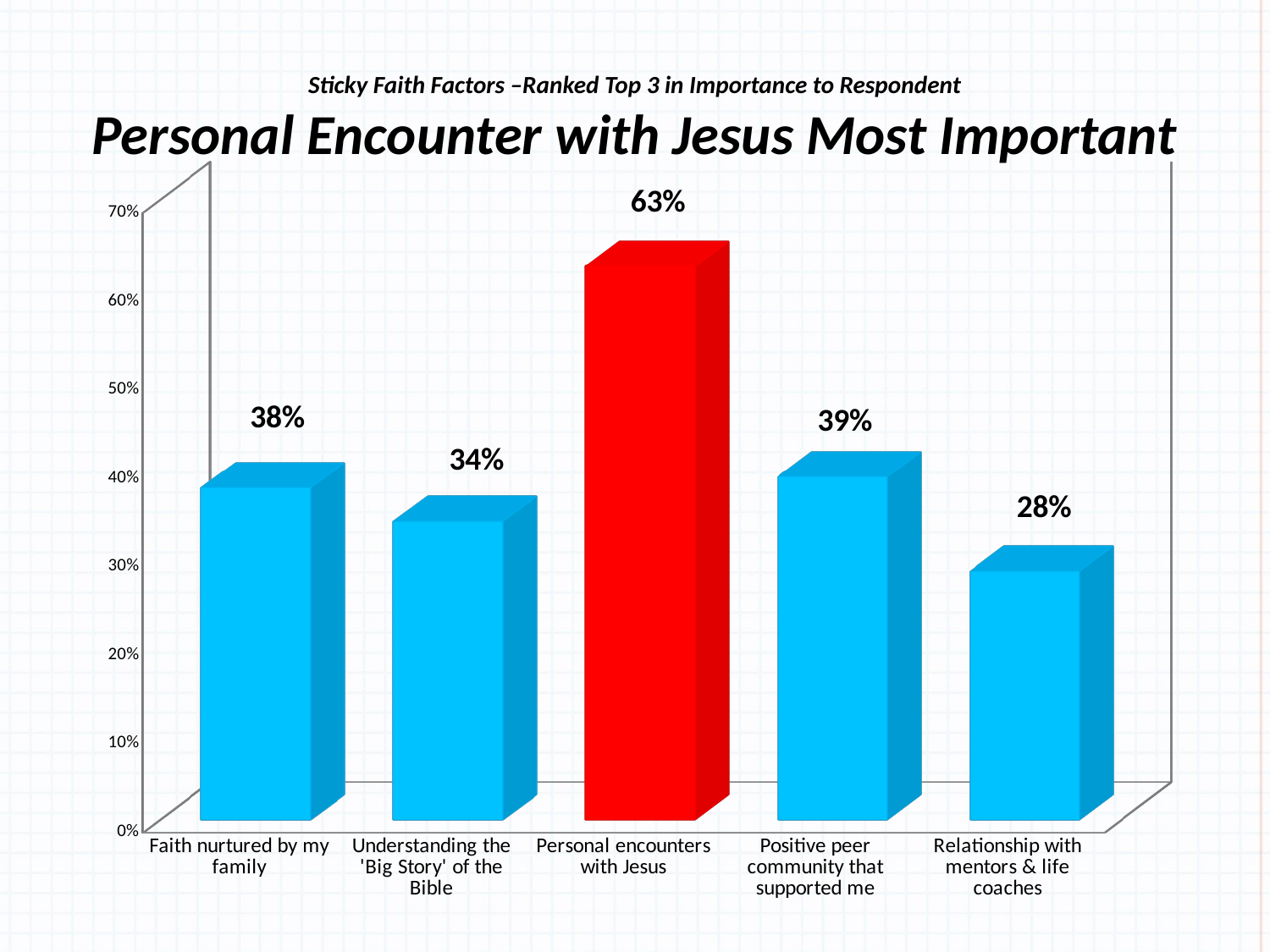
What is the value for 'Faith nurtured by my family'? 38% What is the difference between 'Faith nurtured by my family' and 'Understanding the 'Big Story' of the Bible'? 4% Is the value for 'Personal encounters with Jesus' greater or less than 60%? greater Which category has the highest value? Personal encounters with Jesus Which category has the lowest value? Relationship with mentors & life coaches What is the difference between 'Personal encounters with Jesus' and 'Positive peer community that supported me'? 24% How many categories are shown on the chart? 5 What is the value for 'Relationship with mentors & life coaches'? 28% What is the value for 'Personal encounters with Jesus'? 63% Which is larger: 'Understanding the 'Big Story' of the Bible' or 'Relationship with mentors & life coaches'? Understanding the 'Big Story' of the Bible Which bar is coloured red rather than blue? Personal encounters with Jesus What kind of chart is shown on the slide? bar chart